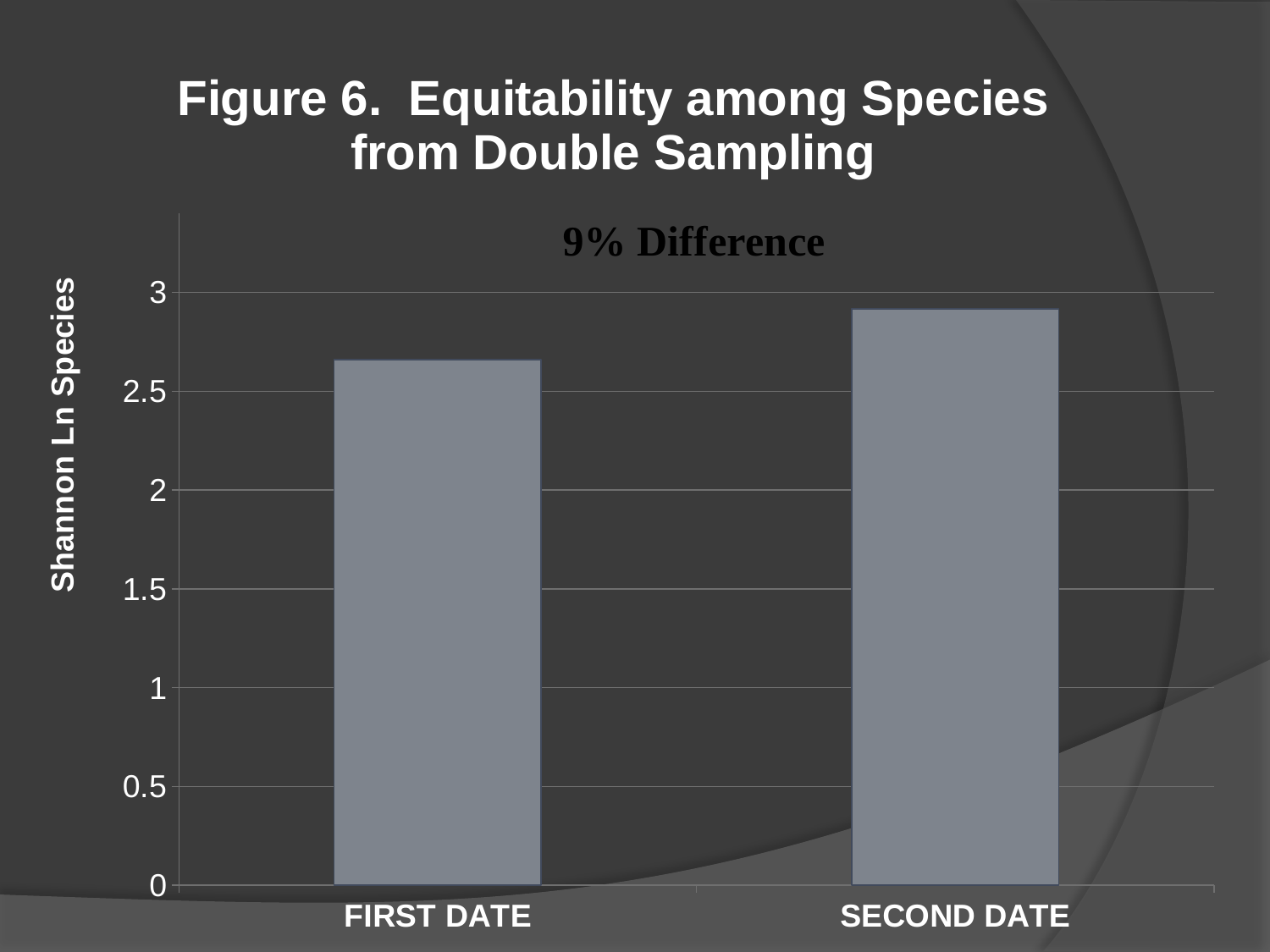
Is the value for SECOND DATE greater or less than 2.5? greater Is the value for FIRST DATE greater or less than 2.5? greater Which category has the higher Shannon Ln Species value? SECOND DATE How many categories are plotted on the x axis? 2 What percentage difference is annotated on the chart? 9% Difference What kind of chart is shown on the slide? bar chart Which category has the lower Shannon Ln Species value? FIRST DATE Is the value for FIRST DATE greater or less than 3? less Is the bar for SECOND DATE taller or shorter than the bar for FIRST DATE? taller Do the values rise or fall from FIRST DATE to SECOND DATE? rise What is the label of the y axis? Shannon Ln Species